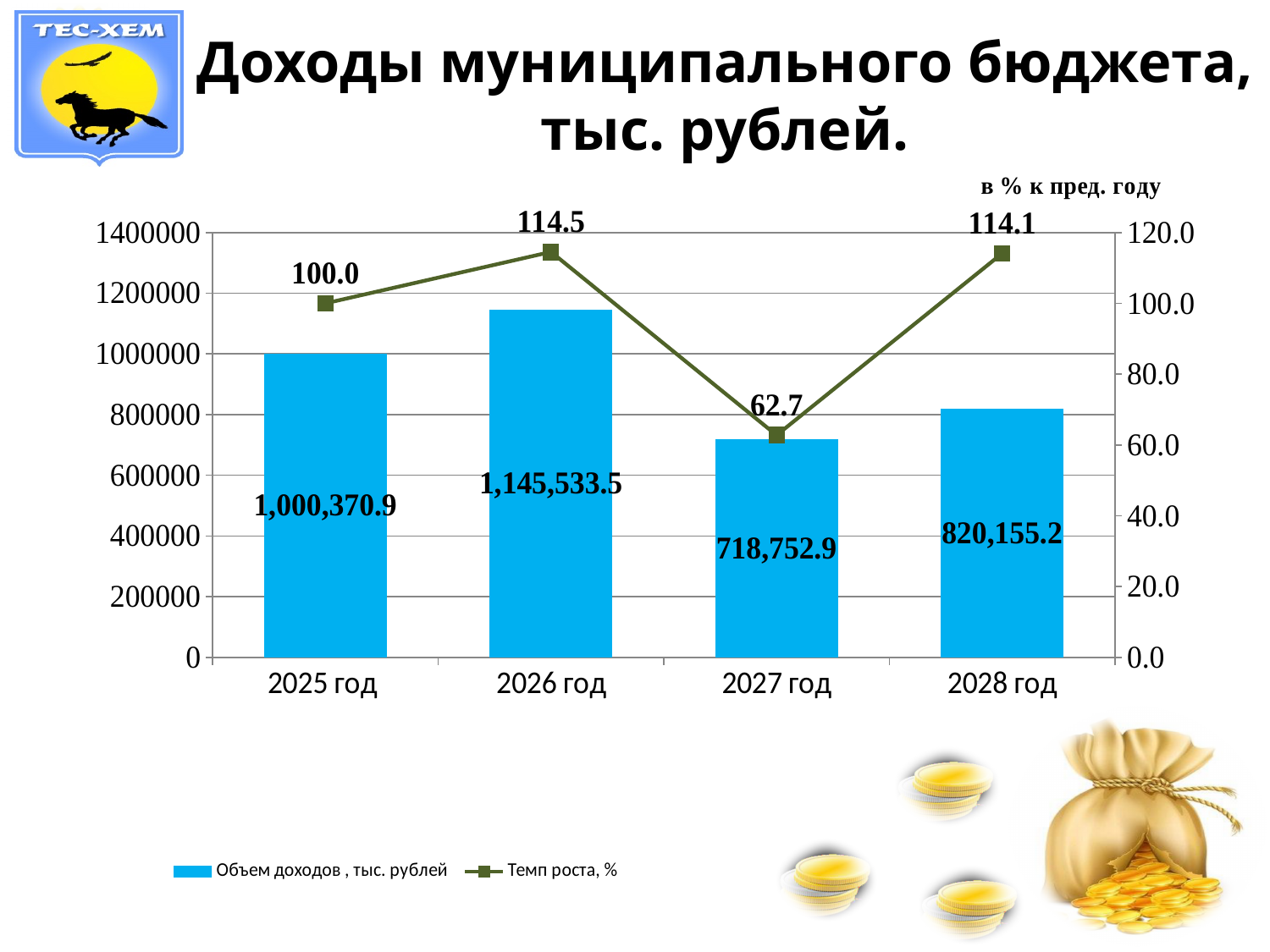
Which year has the lowest value of "Темп роста, %"? 2027 год What kind of chart is shown on the slide? Combined bar and line chart What is the difference in "Объем доходов, тыс. рублей" between 2026 год and 2025 год? 145,162.6 Which year has the highest value of "Объем доходов, тыс. рублей"? 2026 год What is the value of "Объем доходов, тыс. рублей" for 2028 год? 820,155.2 What is the difference in "Темп роста, %" between 2026 год and 2027 год? 51.8 What is the value of "Темп роста, %" for 2025 год? 100.0 What is the value of "Объем доходов, тыс. рублей" for 2026 год? 1,145,533.5 How many series does the chart legend list? 2 What is the value of "Темп роста, %" for 2027 год? 62.7 Which year has a larger value of "Объем доходов, тыс. рублей": 2027 год or 2028 год? 2028 год How many years are shown on the x axis of the chart? 4